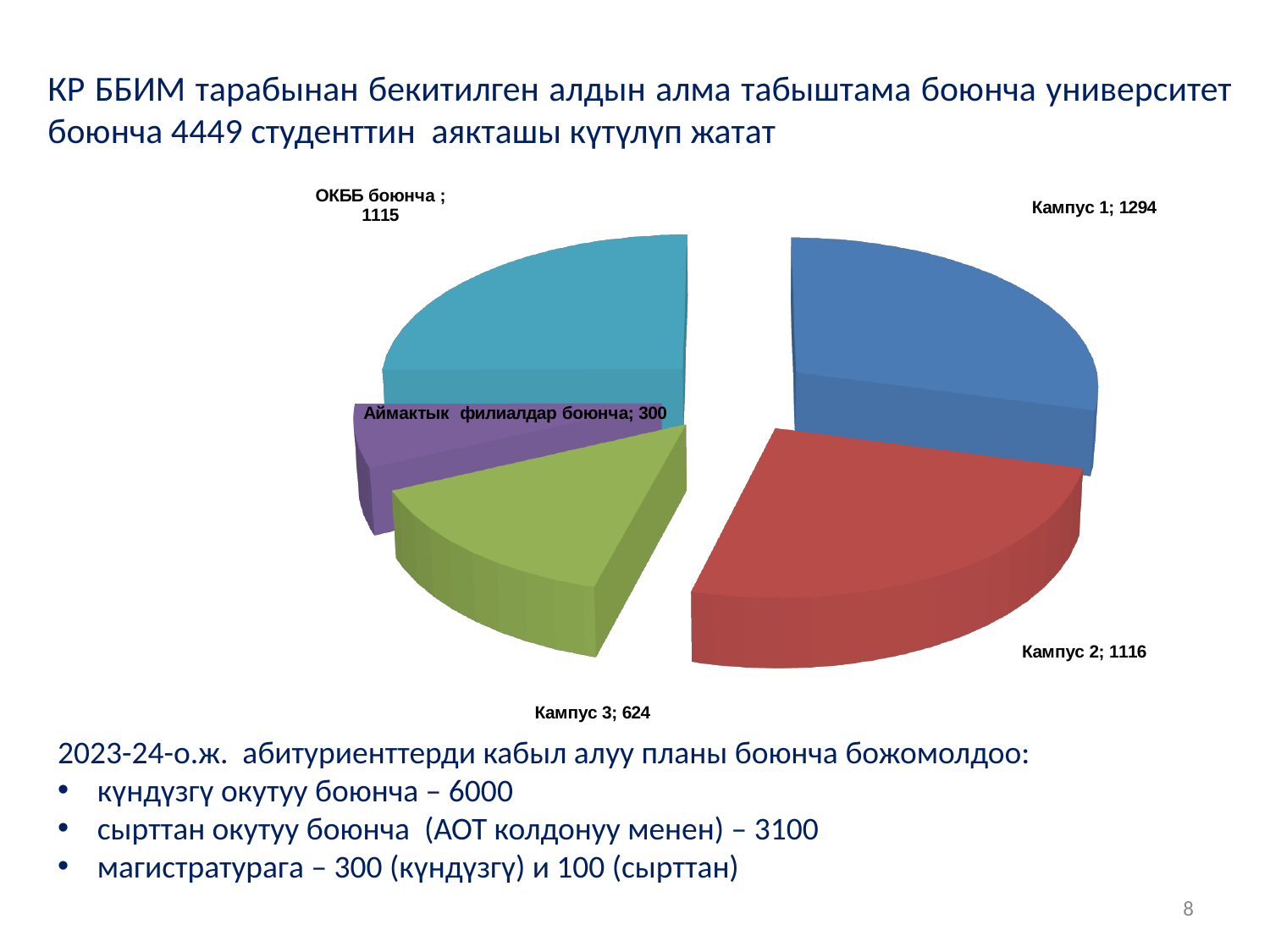
Which category has the smallest value in the pie chart? Аймактык филиалдар боюнча What colour is the Кампус 1 slice of the pie chart? blue Which is larger, the value for Кампус 1 or the value for Кампус 3? Кампус 1 Which category has the largest value in the pie chart? Кампус 1 What is the value for Аймактык филиалдар боюнча? 300 What is the value for Кампус 1? 1294 What is the difference between the values for Кампус 2 and Аймактык филиалдар боюнча? 816 What kind of chart is shown on the slide? pie chart How many slices does the pie chart have? 5 What is the value for Кампус 3? 624 What is the difference between the values for Кампус 1 and Кампус 3? 670 What is the value for ОКББ боюнча? 1115